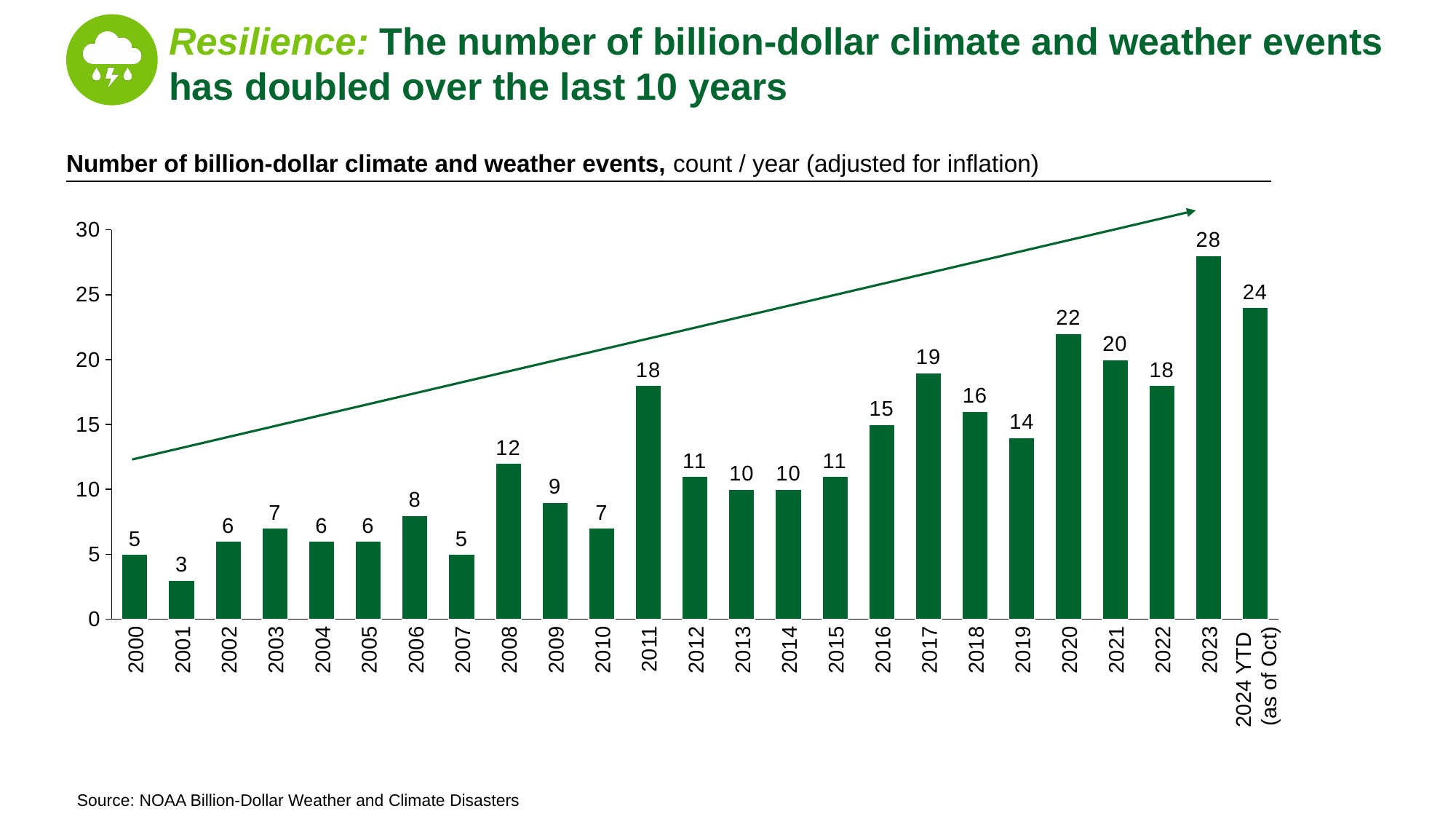
Do the values generally rise or fall from 2000 to 2023? Rise What kind of chart is shown on the slide? Bar chart Is the value for 2020 greater or less than 20? greater What is the number of billion-dollar climate and weather events in 2023? 28 Which year has the lowest number of billion-dollar climate and weather events? 2001 Which year had more billion-dollar events, 2017 or 2019? 2017 What is the difference between the number of events in 2023 and in 2022? 10 What is the number of billion-dollar climate and weather events in 2011? 18 How many years (categories) are shown on the x axis? 25 Which year has the highest number of billion-dollar climate and weather events? 2023 What is the value shown for 2024 YTD (as of Oct)? 24 What is the source cited for the chart? NOAA Billion-Dollar Weather and Climate Disasters